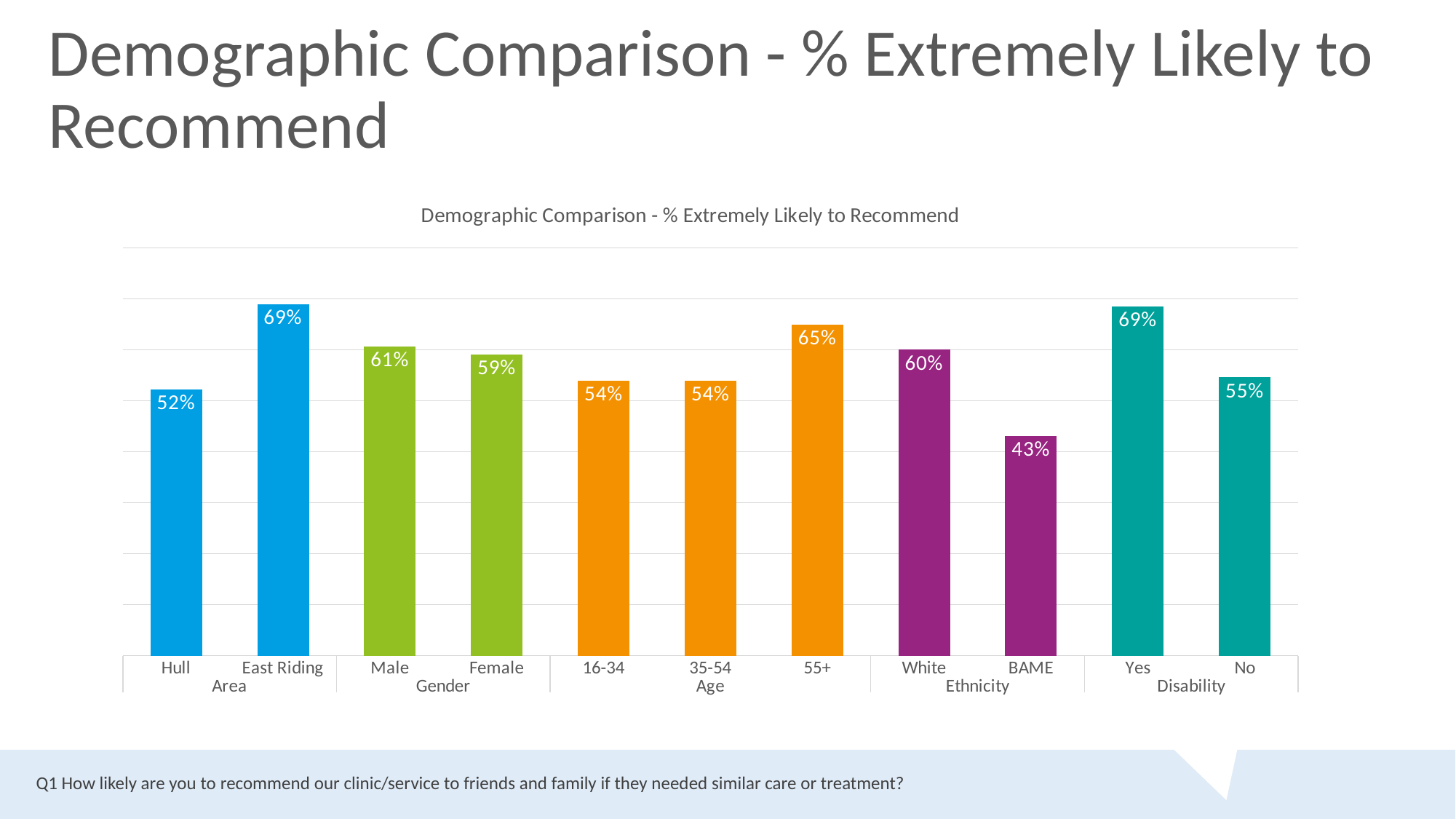
Which category has the lowest value? BAME What is the title of the chart? Demographic Comparison - % Extremely Likely to Recommend What is the difference between White and BAME? 17% Which is larger, Disability Yes or Disability No? Yes What kind of chart is shown? Bar chart Which is larger, Male or Female? Male What is the difference between East Riding and Hull? 17% What is the value for Female? 59% What is the value for Hull? 52% How many bars are plotted on the chart? 11 What is the value for BAME? 43% What is the value for the 55+ age group? 65%